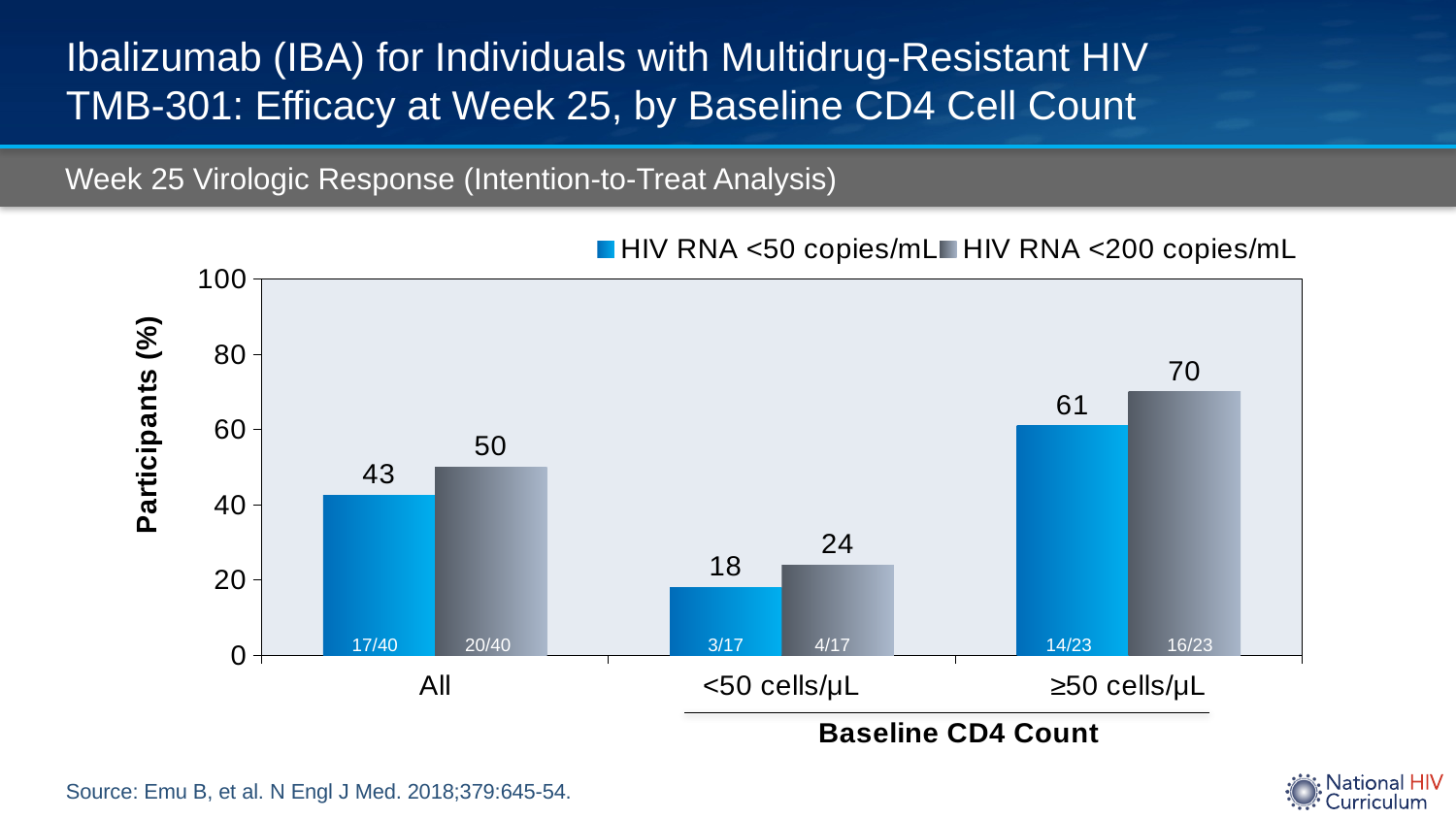
What fraction is printed on the HIV RNA <200 copies/mL bar for the ≥50 cells/µL group? 16/23 What is the difference between the HIV RNA <200 copies/mL and HIV RNA <50 copies/mL percentages in the ≥50 cells/µL group? 9 What percentage of participants in the All group achieved HIV RNA <50 copies/mL? 43 How many baseline CD4 categories are shown on the x axis? 3 Which is larger: the HIV RNA <50 copies/mL percentage for the All group or for the <50 cells/µL group? All Which baseline CD4 category has the highest percentage of participants with HIV RNA <50 copies/mL? ≥50 cells/µL What kind of chart is shown on the slide? Bar chart What percentage of participants with baseline CD4 ≥50 cells/µL achieved HIV RNA <200 copies/mL? 70 How many series does the legend list? 2 What percentage of participants with baseline CD4 <50 cells/µL achieved HIV RNA <50 copies/mL? 18 What is the label of the y axis? Participants (%) Which category has the lowest percentage of participants with HIV RNA <200 copies/mL? <50 cells/µL